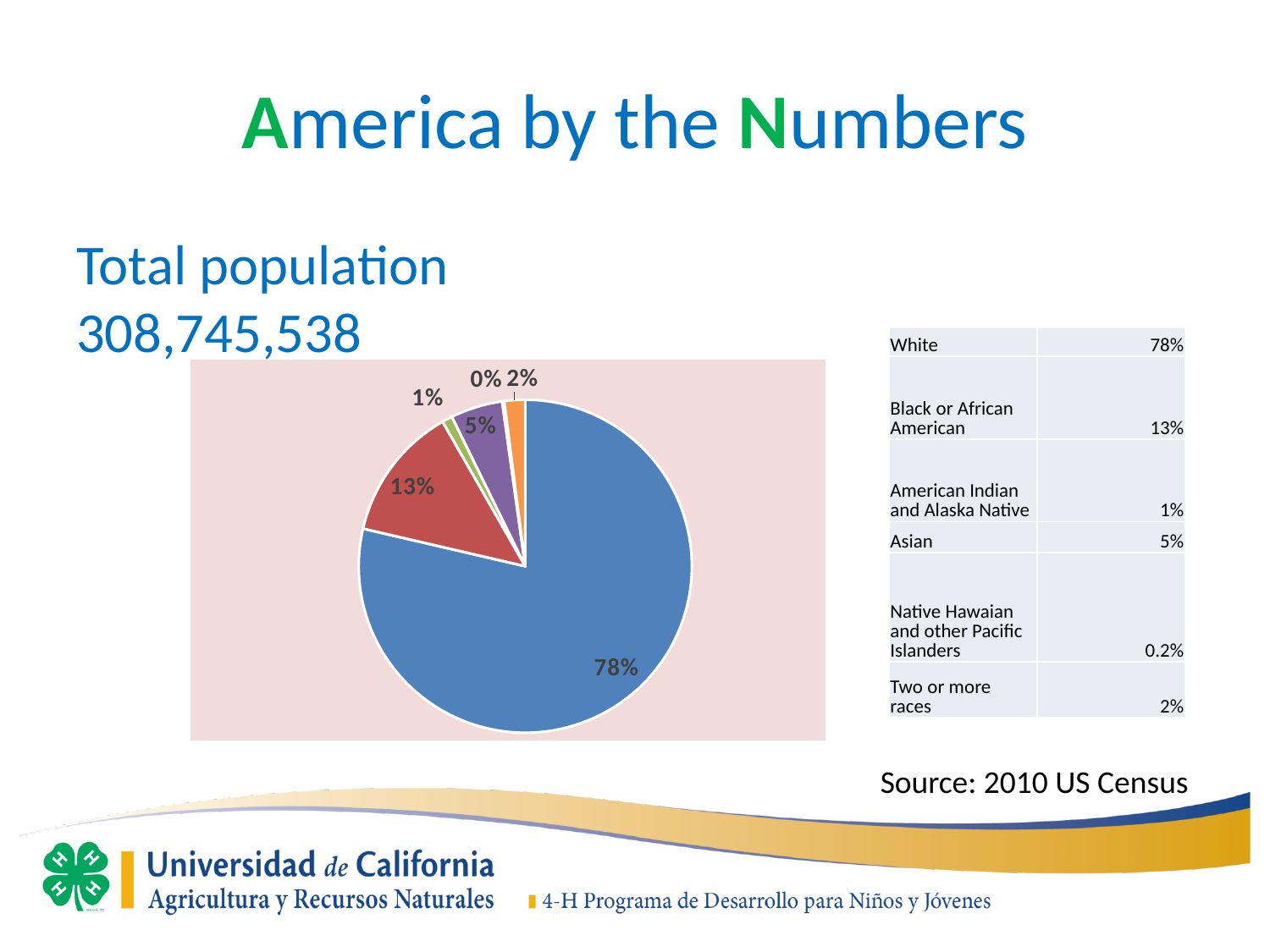
What is the difference in percentage points between the White slice and the Black or African American slice? 65 What percentage is shown for Black or African American? 13% What percentage is shown for American Indian and Alaska Native? 1% Which category has the largest slice of the pie chart? White How many slices does the pie chart have? 6 Which category has the smallest slice of the pie chart? Native Hawaian and other Pacific Islanders Which slice is larger, Asian or Two or more races? Asian What share of the pie chart is labelled for White? 78% What kind of chart is shown on the slide? pie chart What percentage is shown for Two or more races? 2% What is the title of the slide containing the pie chart? America by the Numbers What percentage is shown for Asian? 5%